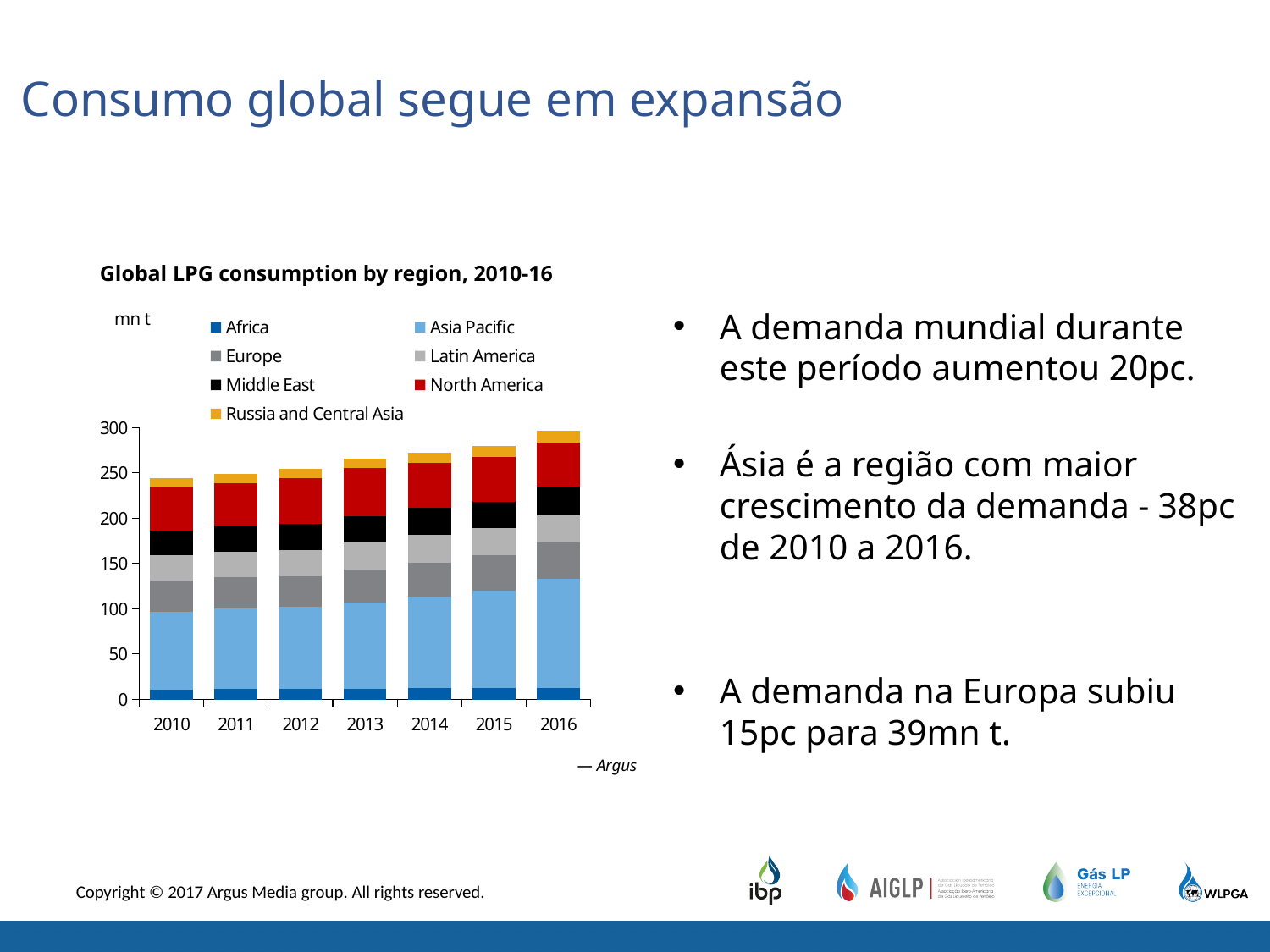
What kind of chart is shown on the slide? stacked bar chart Which year has the larger total LPG consumption, 2010 or 2016? 2016 Which year has the lowest total LPG consumption in the chart? 2010 What unit is shown on the chart's y axis? mn t Is the Asia Pacific value for 2016 greater or less than 100? greater What is the title of the chart? Global LPG consumption by region, 2010-16 How many regions does the chart's legend list? 7 Does total global LPG consumption rise or fall from 2010 to 2016? rise Is the total LPG consumption for 2010 greater or less than 200? greater How many years are shown on the x axis of the chart? 7 Which year has the highest total LPG consumption in the chart? 2016 Is the total LPG consumption for 2016 greater or less than 250? greater